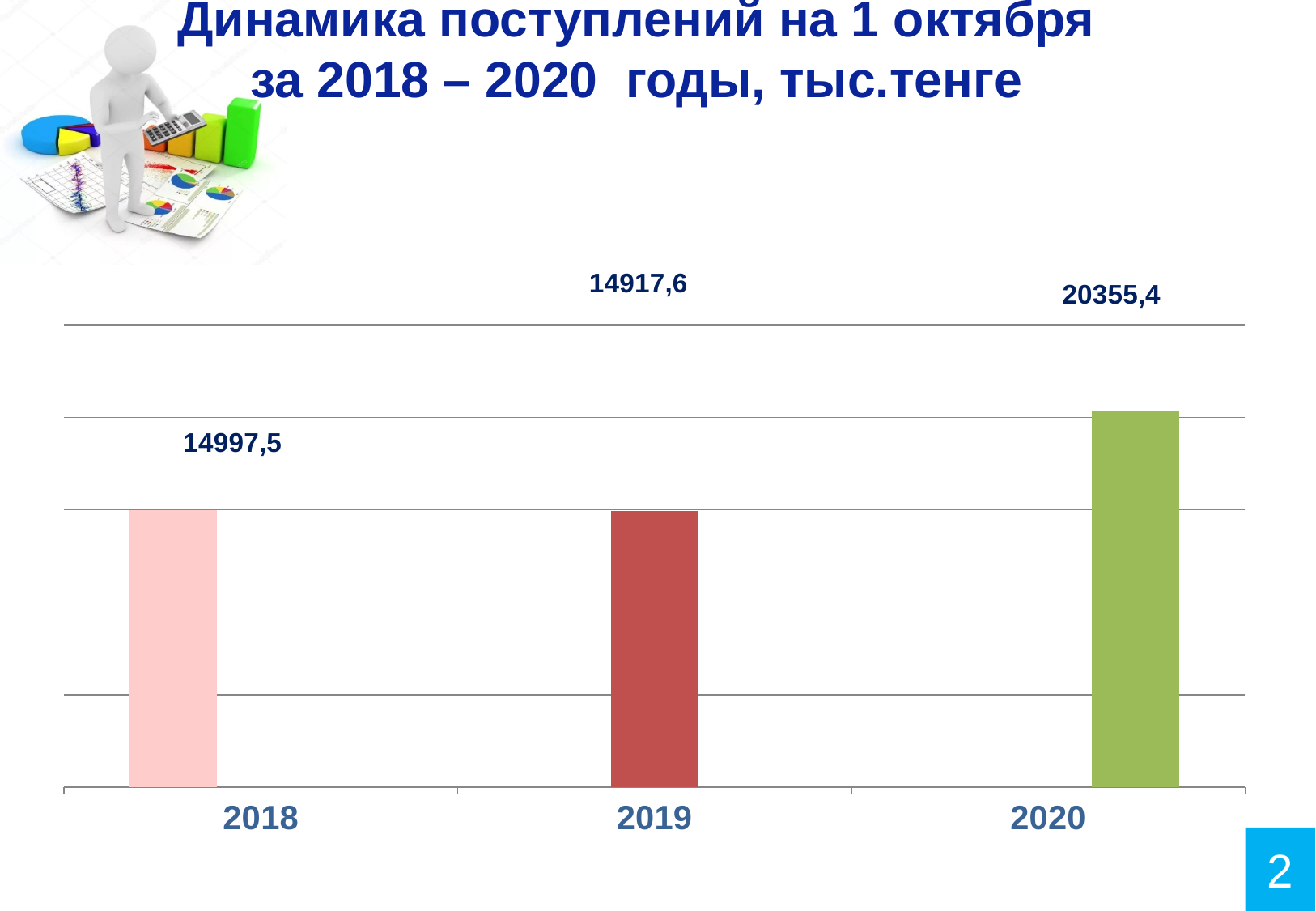
What is the difference between the values for 2020 and 2018? 5357,9 What is the value for 2018? 14997,5 Which is larger, the value for 2020 or the value for 2018? 2020 Does the value rise or fall from 2019 to 2020? rise Which year has the highest value? 2020 Which is larger, the value for 2019 or the value for 2020? 2020 What kind of chart is shown on the slide? bar chart What is the value for 2019? 14917,6 What is the difference between the values for 2020 and 2019? 5437,8 What unit is stated in the chart title? тыс.тенге How many years are shown on the x axis? 3 What is the value for 2020? 20355,4